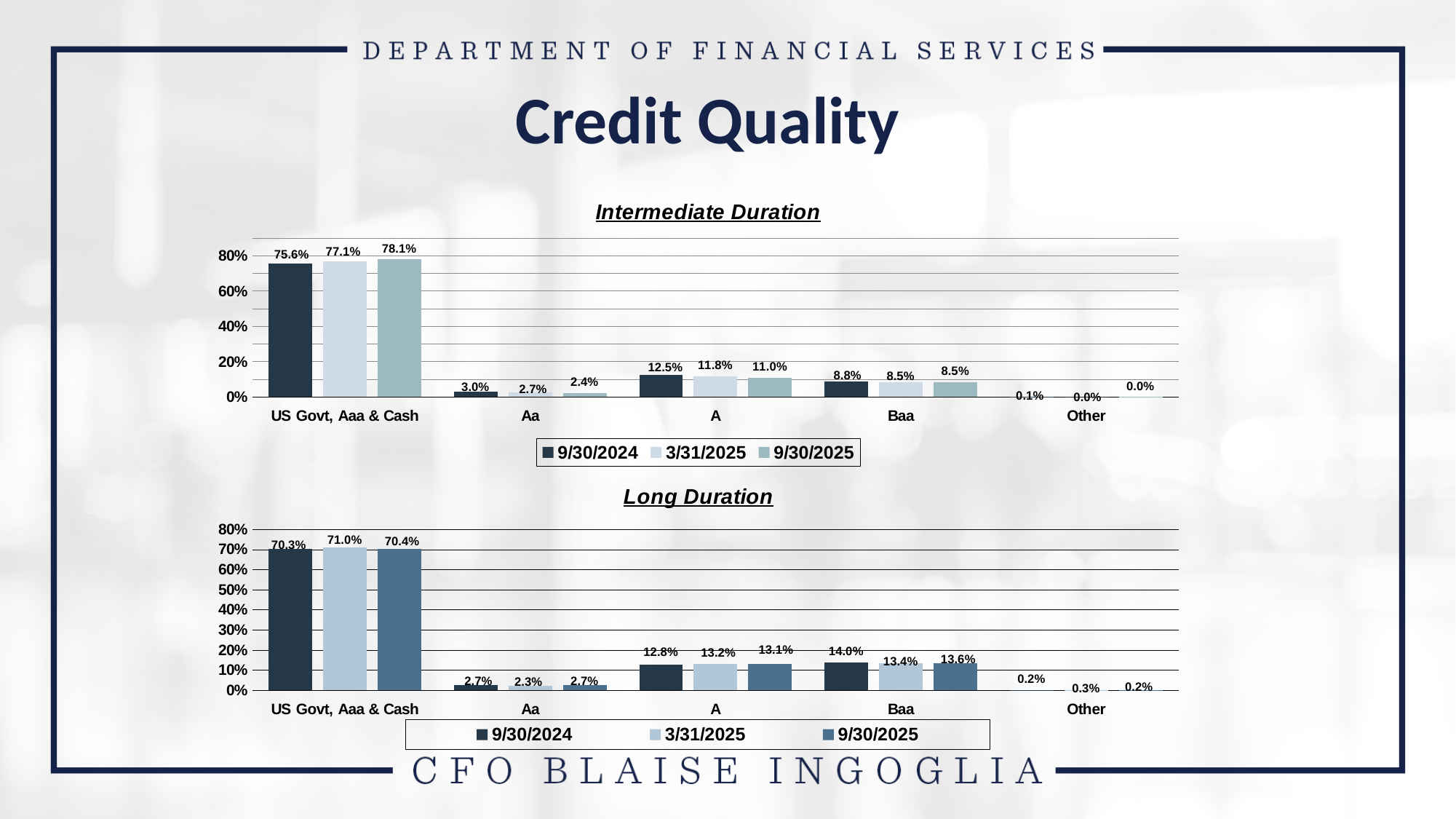
In the Intermediate Duration chart, do the values for Aa rise or fall from 9/30/2024 to 9/30/2025? Fall In the Intermediate Duration chart, what is the value for US Govt, Aaa & Cash on 9/30/2025? 78.1% In the Long Duration chart, which is larger for A: the 3/31/2025 value or the 9/30/2024 value? 3/31/2025 What kind of chart is the Long Duration chart? Bar chart In the Intermediate Duration chart, what is the difference between the 9/30/2025 and 9/30/2024 values for US Govt, Aaa & Cash? 2.5% In the Long Duration chart, what is the value for Aa on 9/30/2025? 2.7% In the Long Duration chart, which category has the lowest value for 9/30/2024? Other How many categories are shown on the x axis of the Intermediate Duration chart? 5 In the Long Duration chart, what is the value for Baa on 3/31/2025? 13.4% In the Intermediate Duration chart, which category has the highest value for 9/30/2024? US Govt, Aaa & Cash In the Intermediate Duration chart, what is the value for A on 9/30/2024? 12.5% How many series does the legend of the Long Duration chart list? 3